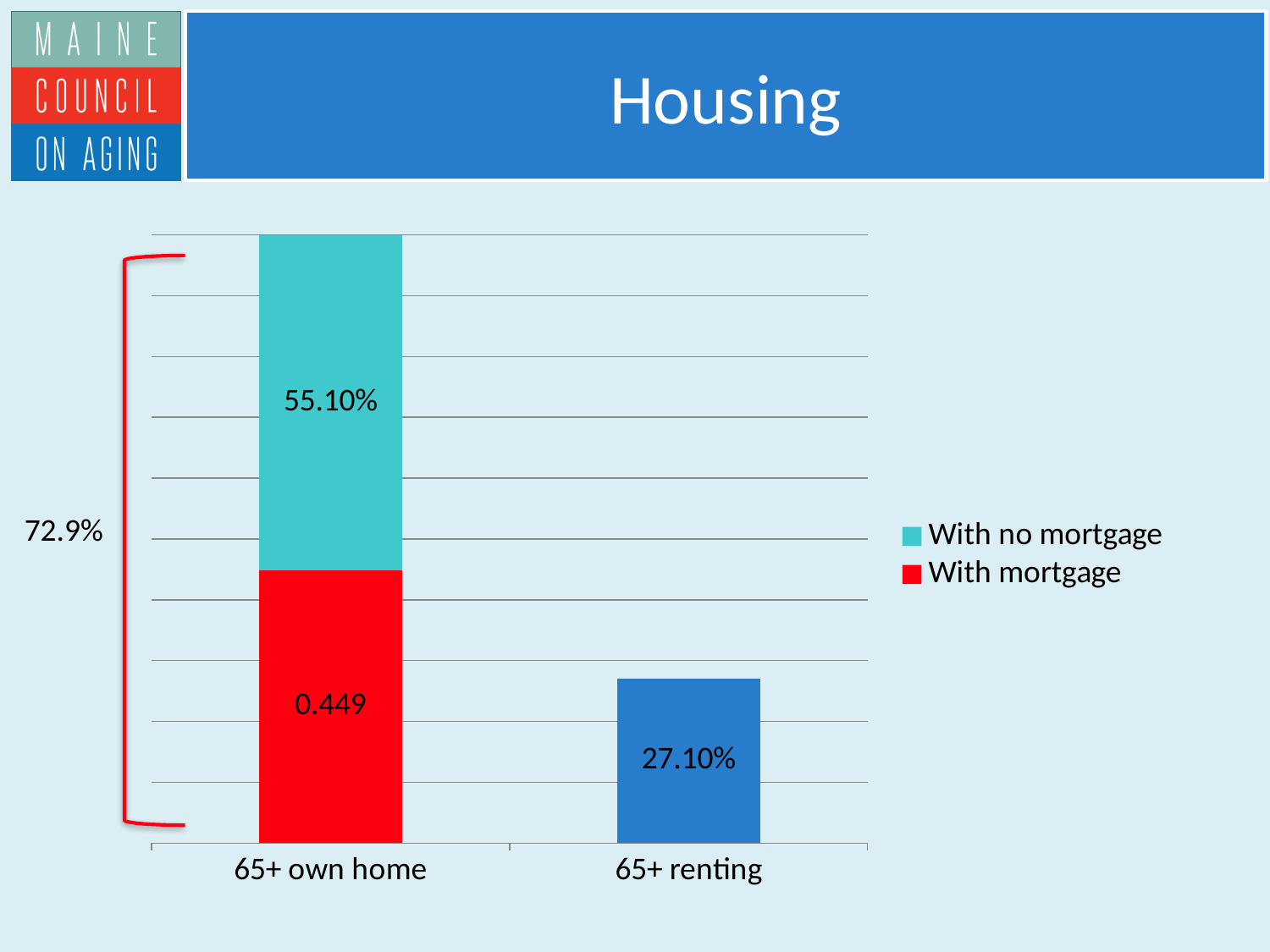
What kind of chart is shown on the slide? Bar chart How many series does the legend list? 2 What are the two entries in the chart legend? With no mortgage; With mortgage Which category has the taller bar, '65+ own home' or '65+ renting'? 65+ own home Within the '65+ own home' bar, which segment is larger, 'With no mortgage' or 'With mortgage'? With no mortgage What value is shown on the bar for '65+ renting'? 27.10% What is the value of the 'With no mortgage' segment for '65+ own home'? 55.10% How many categories are shown on the x axis of the chart? 2 What is the value of the 'With mortgage' segment for '65+ own home'? 0.449 What percentage is written next to the red bracket beside the '65+ own home' bar? 72.9% Which category has the shortest bar in the chart? 65+ renting What is the difference between the 'With no mortgage' value for '65+ own home' (55.10%) and the '65+ renting' value (27.10%)? 28.00%